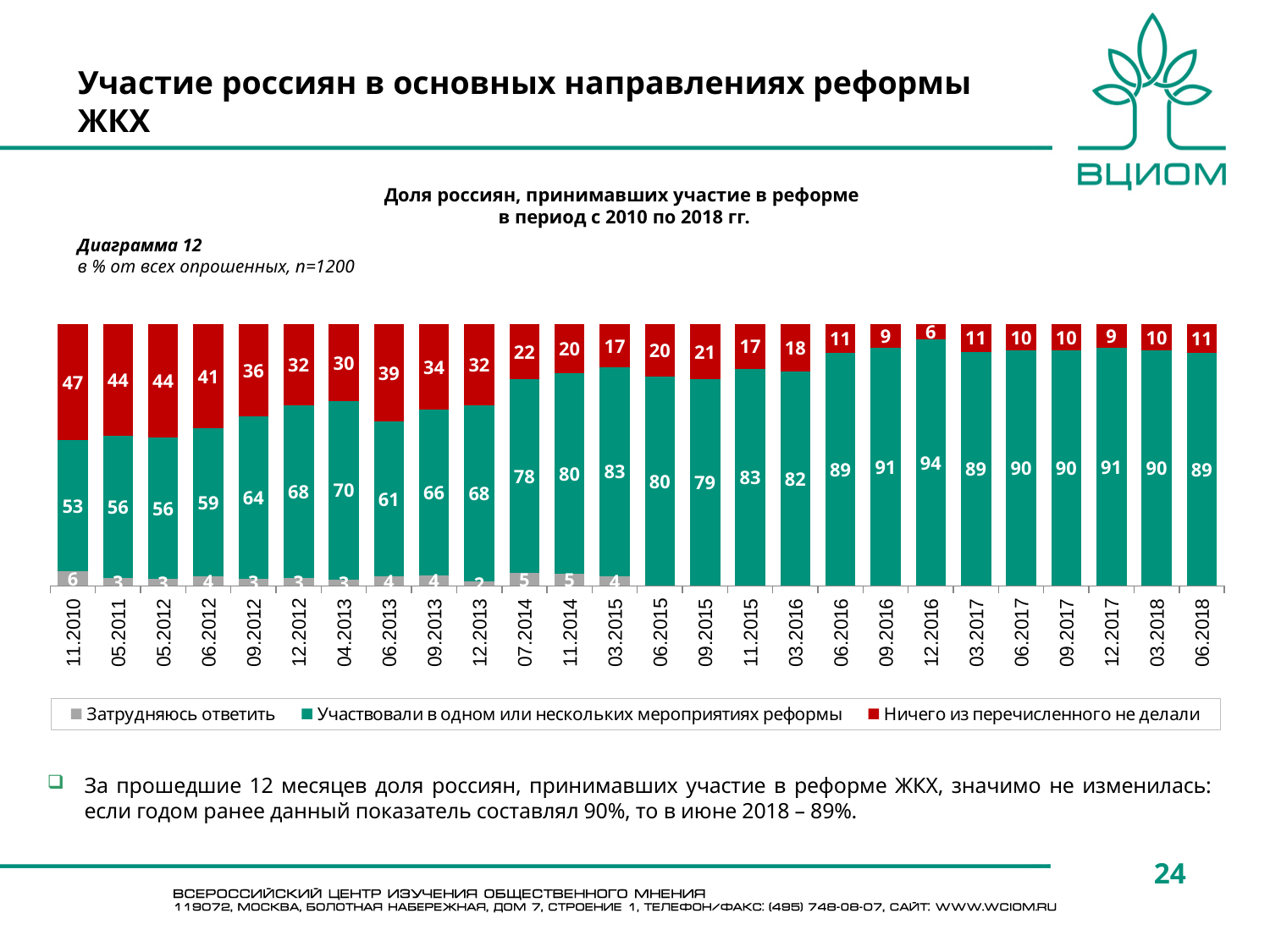
What colour represents "Ничего из перечисленного не делали" in the chart? Red What is the value for "Участвовали в одном или нескольких мероприятиях реформы" in 11.2010? 53 Which is larger: the "Ничего из перечисленного не делали" value in 06.2013 or in 04.2013? 06.2013 What kind of chart is shown on the slide? Stacked bar chart In which period is the value for "Участвовали в одном или нескольких мероприятиях реформы" highest? 12.2016 How many series does the legend list? 3 In which period is the value for "Ничего из перечисленного не делали" highest? 11.2010 In which period is the value for "Ничего из перечисленного не делали" lowest? 12.2016 Does the value for "Участвовали в одном или нескольких мероприятиях реформы" generally rise or fall from 11.2010 to 06.2018? Rise What is the value for "Ничего из перечисленного не делали" in 06.2018? 11 How many time periods (categories) are shown on the x axis? 26 What is the difference between the "Участвовали в одном или нескольких мероприятиях реформы" values in 06.2018 and 11.2010? 36